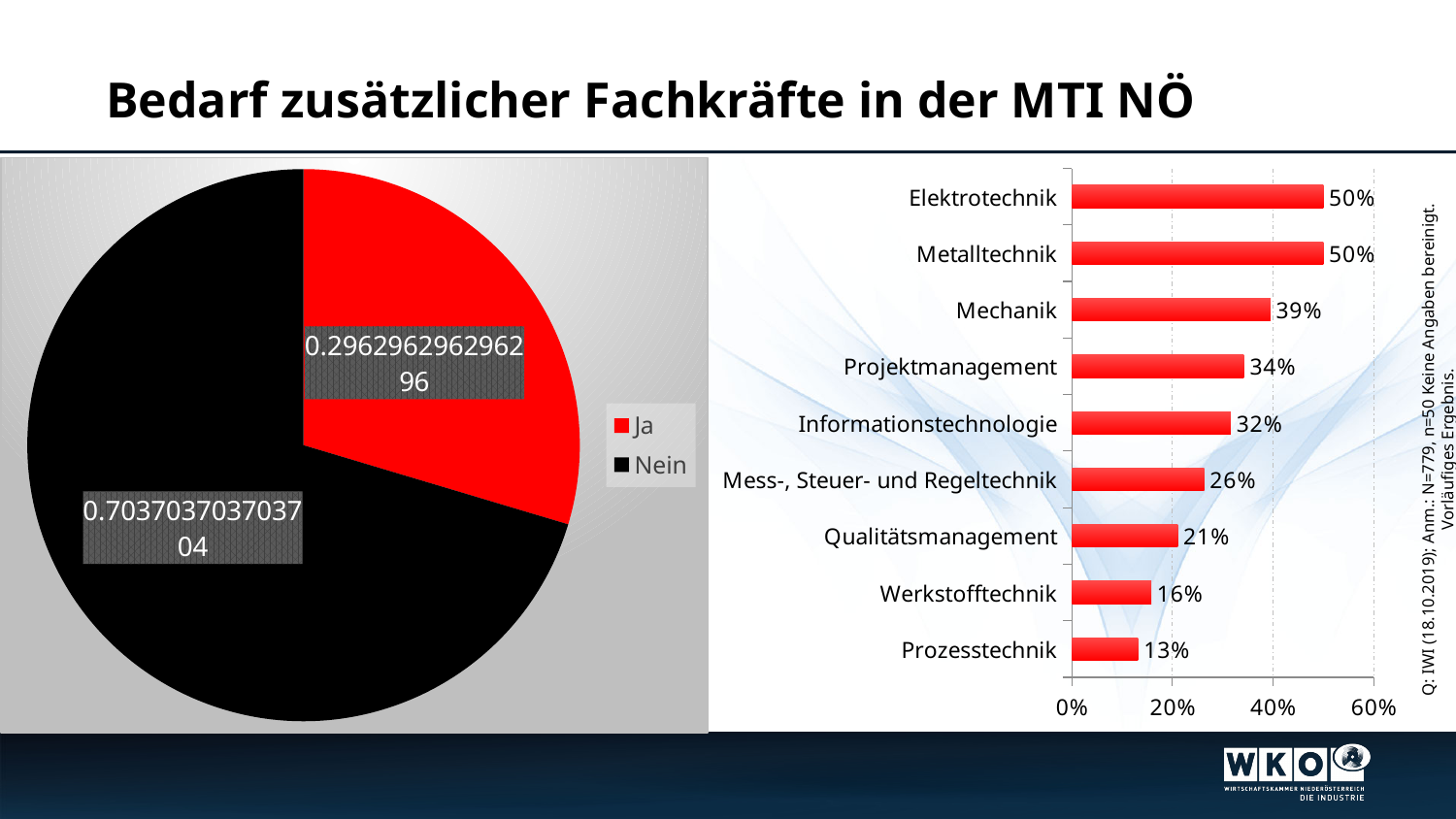
On the pie chart on the left, what colour is the Ja slice? red What kind of chart is on the right side of the slide? bar chart On the bar chart on the right, what is the value for Mess-, Steuer- und Regeltechnik? 26% On the pie chart on the left, which slice is larger: Ja or Nein? Nein On the bar chart on the right, how many categories are shown? 9 On the bar chart on the right, what is the value for Qualitätsmanagement? 21% On the pie chart on the left, how many entries does the legend list? 2 On the bar chart on the right, what is the difference between the values for Mechanik and Prozesstechnik? 26 percentage points On the bar chart on the right, which category has the lowest value? Prozesstechnik On the bar chart on the right, which is larger: Projektmanagement or Informationstechnologie? Projektmanagement On the bar chart on the right, do the values rise or fall from the top category to the bottom category? fall On the bar chart on the right, what is the value for Mechanik? 39%